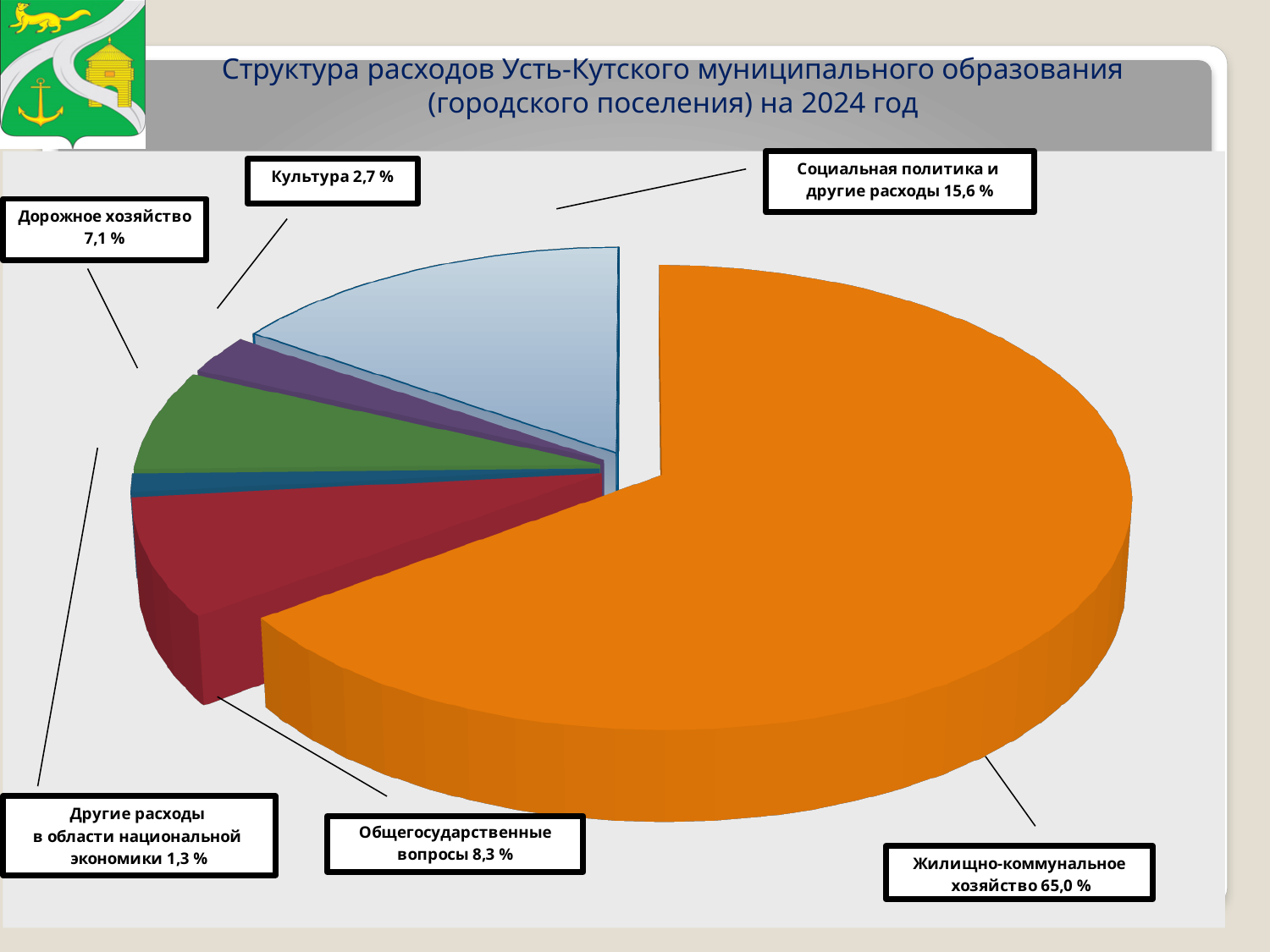
Каким цветом показан сектор жилищно-коммунального хозяйства? Оранжевым Какого типа эта диаграмма? Круговая диаграмма Какая доля расходов приходится на культуру? 2,7 % Сколько категорий расходов показано на диаграмме? 6 Какая доля расходов приходится на жилищно-коммунальное хозяйство? 65,0 % Какая доля расходов приходится на общегосударственные вопросы? 8,3 % Какая доля расходов приходится на дорожное хозяйство? 7,1 % Какая категория расходов имеет наибольшую долю? Жилищно-коммунальное хозяйство Какая категория расходов имеет наименьшую долю? Другие расходы в области национальной экономики На сколько процентных пунктов доля социальной политики и других расходов больше доли общегосударственных вопросов? 7,3 Что больше: доля дорожного хозяйства или доля культуры? Дорожное хозяйство Какая доля расходов приходится на социальную политику и другие расходы? 15,6 %